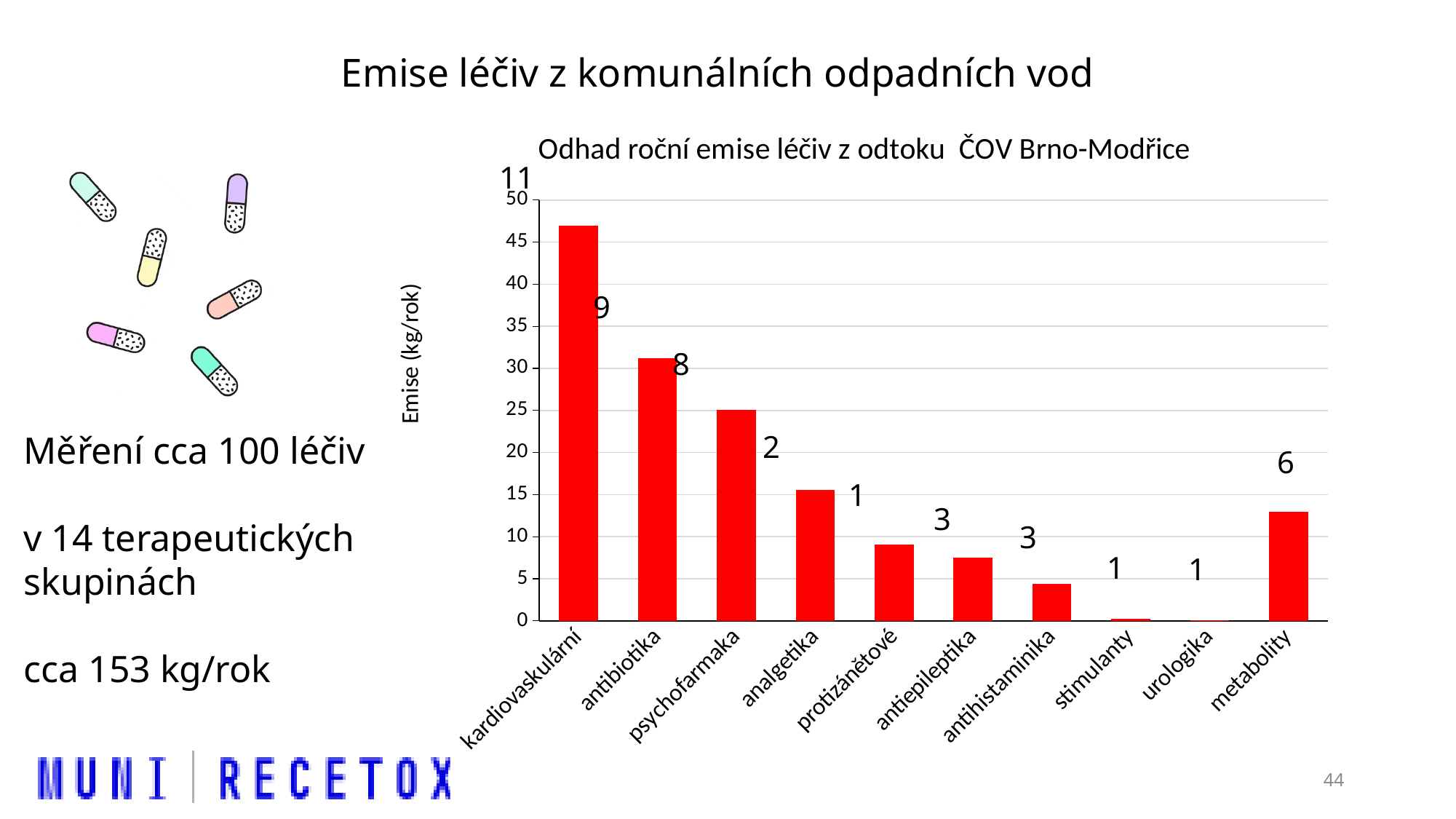
What kind of chart is shown on the slide? bar chart Is the value for kardiovaskulární greater or less than 45? greater Is the value for analgetika greater or less than 20? less Which category has the highest emission value in the chart? kardiovaskulární What is the label of the y axis of the chart? Emise (kg/rok) How many categories are plotted on the x axis of the chart? 10 Which has a larger value, antibiotika or psychofarmaka? antibiotika Which has a larger value, metabolity or antiepileptika? metabolity Is the value for antihistaminika greater or less than 5? less Do the bar values rise or fall from kardiovaskulární to urologika along the x axis? fall